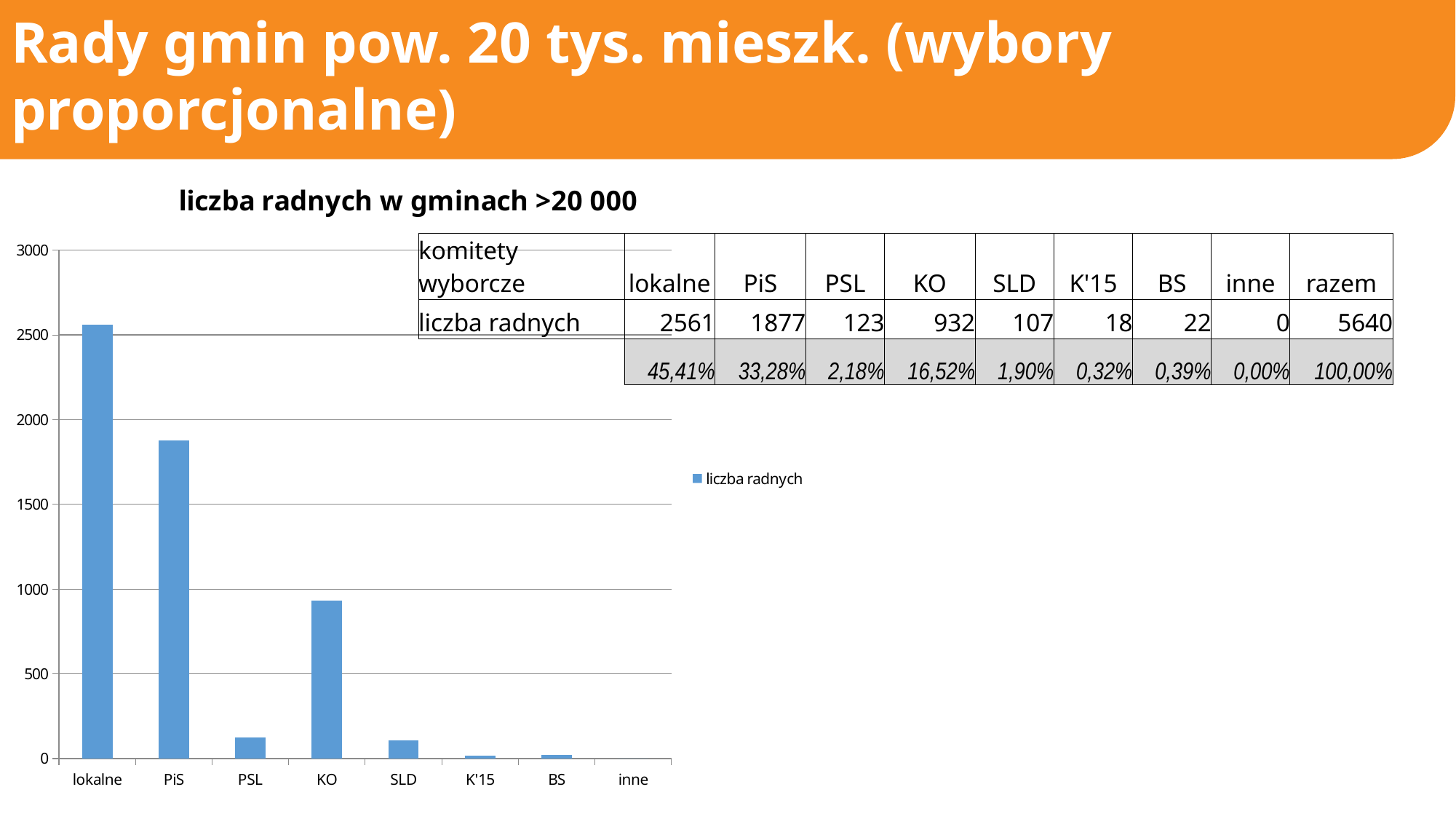
What is the title of the chart? liczba radnych w gminach >20 000 What is the value for KO? 932 Which is larger, the value for PSL or the value for SLD? PSL Which category has the lowest number of radnych? inne How many categories are shown on the x axis of the chart? 8 Is the value for lokalne greater or less than 2500? greater What is the value for PiS? 1877 Is the value for KO greater or less than 1000? less What kind of chart is shown on the slide? bar chart How many series does the chart legend list? 1 Which category has the highest number of radnych? lokalne What is the difference between the values for lokalne and PiS? 684